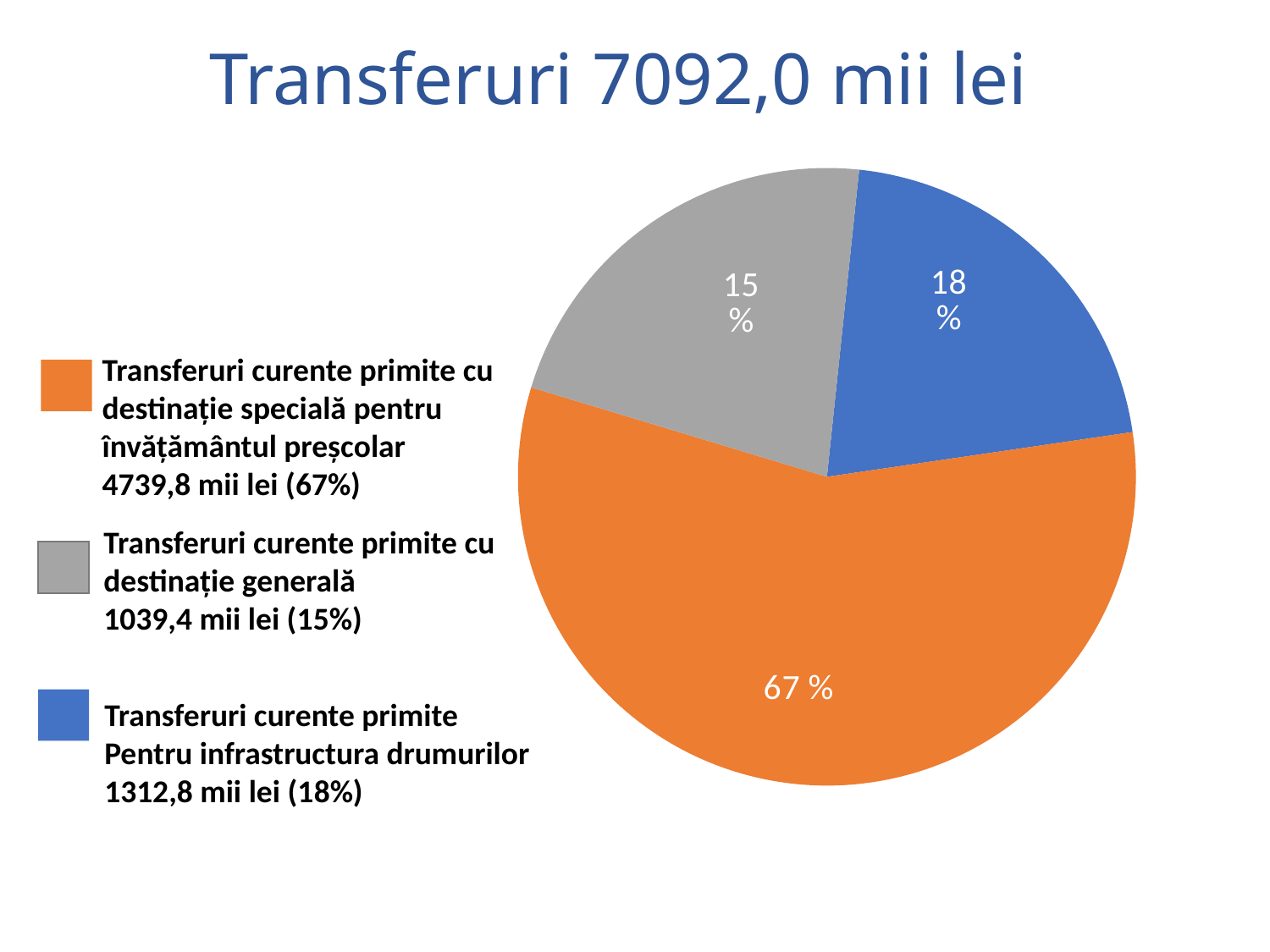
What share of the pie does the orange slice (Transferuri curente primite cu destinație specială pentru învățământul preșcolar) represent? 67% What type of chart is shown on the slide? pie chart How many slices does the pie chart have? 3 What is the title of the slide? Transferuri 7092,0 mii lei What share of the pie does the grey slice (Transferuri curente primite cu destinație generală) represent? 15% Which category has the largest share of the pie? Transferuri curente primite cu destinație specială pentru învățământul preșcolar What is the value in mii lei for Transferuri curente primite cu destinație specială pentru învățământul preșcolar? 4739,8 mii lei What is the difference in percentage points between the orange slice (67%) and the blue slice (18%)? 49 Which category has the smallest share of the pie? Transferuri curente primite cu destinație generală What is the value in mii lei for Transferuri curente primite pentru infrastructura drumurilor? 1312,8 mii lei What share of the pie does the blue slice (Transferuri curente primite pentru infrastructura drumurilor) represent? 18% Which is larger: the share for infrastructura drumurilor or the share for destinație generală? infrastructura drumurilor